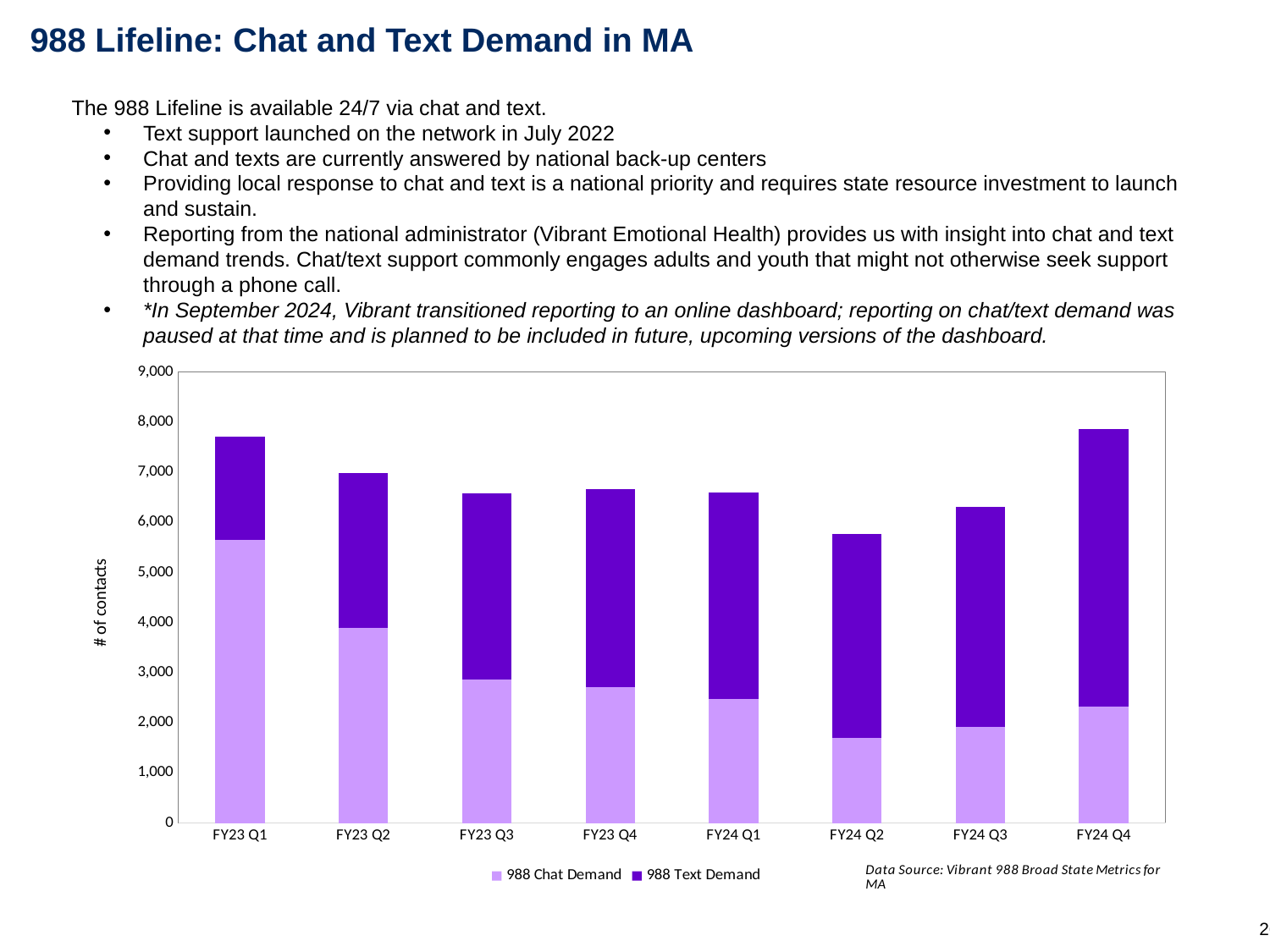
Which is larger, the 988 Chat Demand in FY23 Q2 or in FY24 Q3? FY23 Q2 Which quarter has the lowest total number of contacts (chat plus text)? FY24 Q2 How many series does the chart legend list? 2 Which quarter has the highest 988 Text Demand? FY24 Q4 Is the total number of contacts for FY24 Q4 greater or less than 7,000? greater Which quarter has the highest 988 Chat Demand? FY23 Q1 Is the 988 Chat Demand for FY23 Q1 greater or less than 5,000? greater Is the total number of contacts for FY24 Q2 greater or less than 6,000? less What is the label on the y axis of the chart? # of contacts What kind of chart is shown on the slide? Stacked bar chart How many quarters are shown on the x axis of the chart? 8 Which quarter has the lowest 988 Text Demand? FY23 Q1